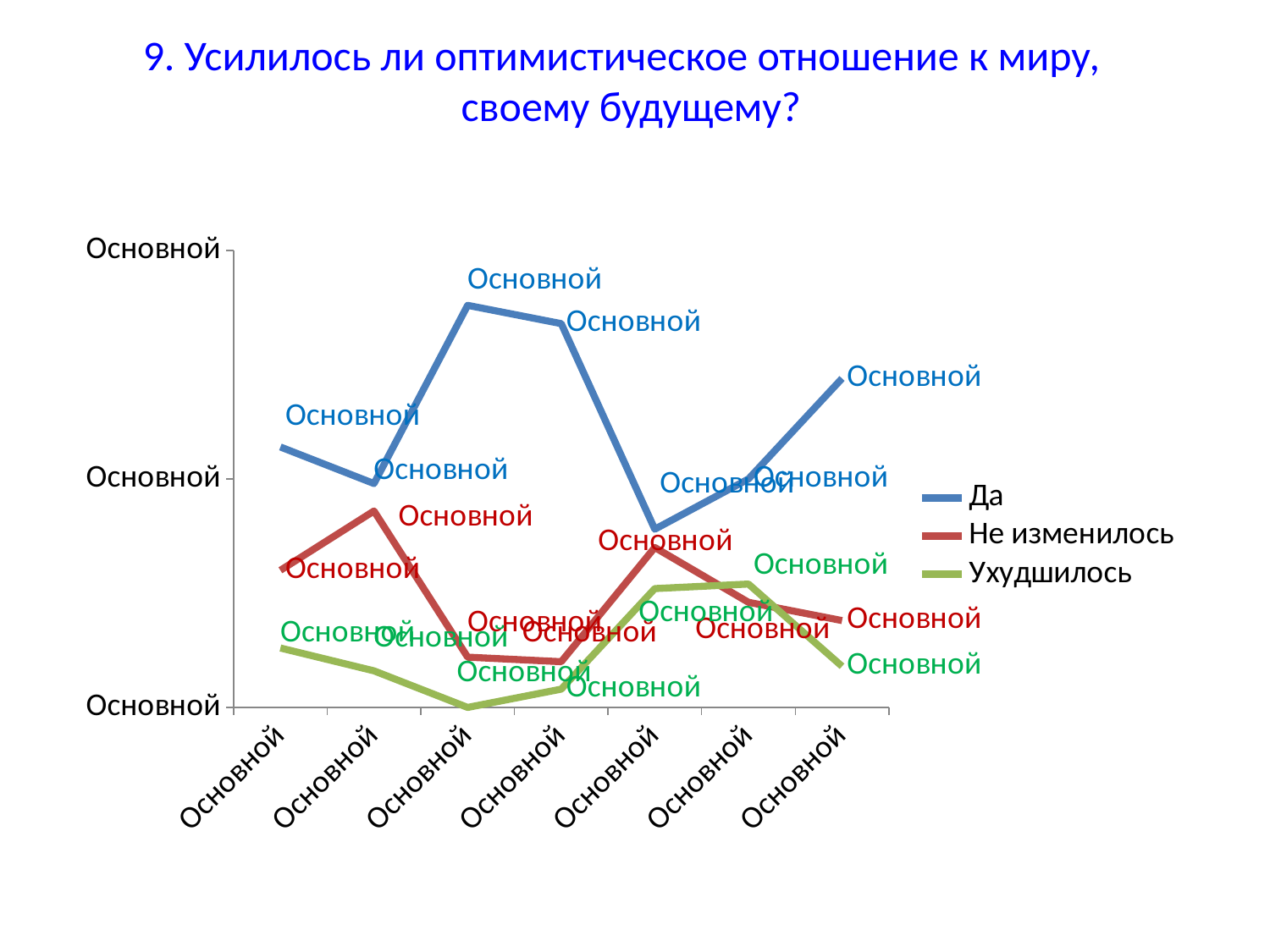
How many data points does each line have? 7 What are the series names listed in the legend? Да, Не изменилось, Ухудшилось Which series is plotted above all the others at every point? Да What is the title of the slide above the chart? 9. Усилилось ли оптимистическое отношение к миру, своему будущему? What kind of chart is shown on the slide? line chart How many series does the legend list? 3